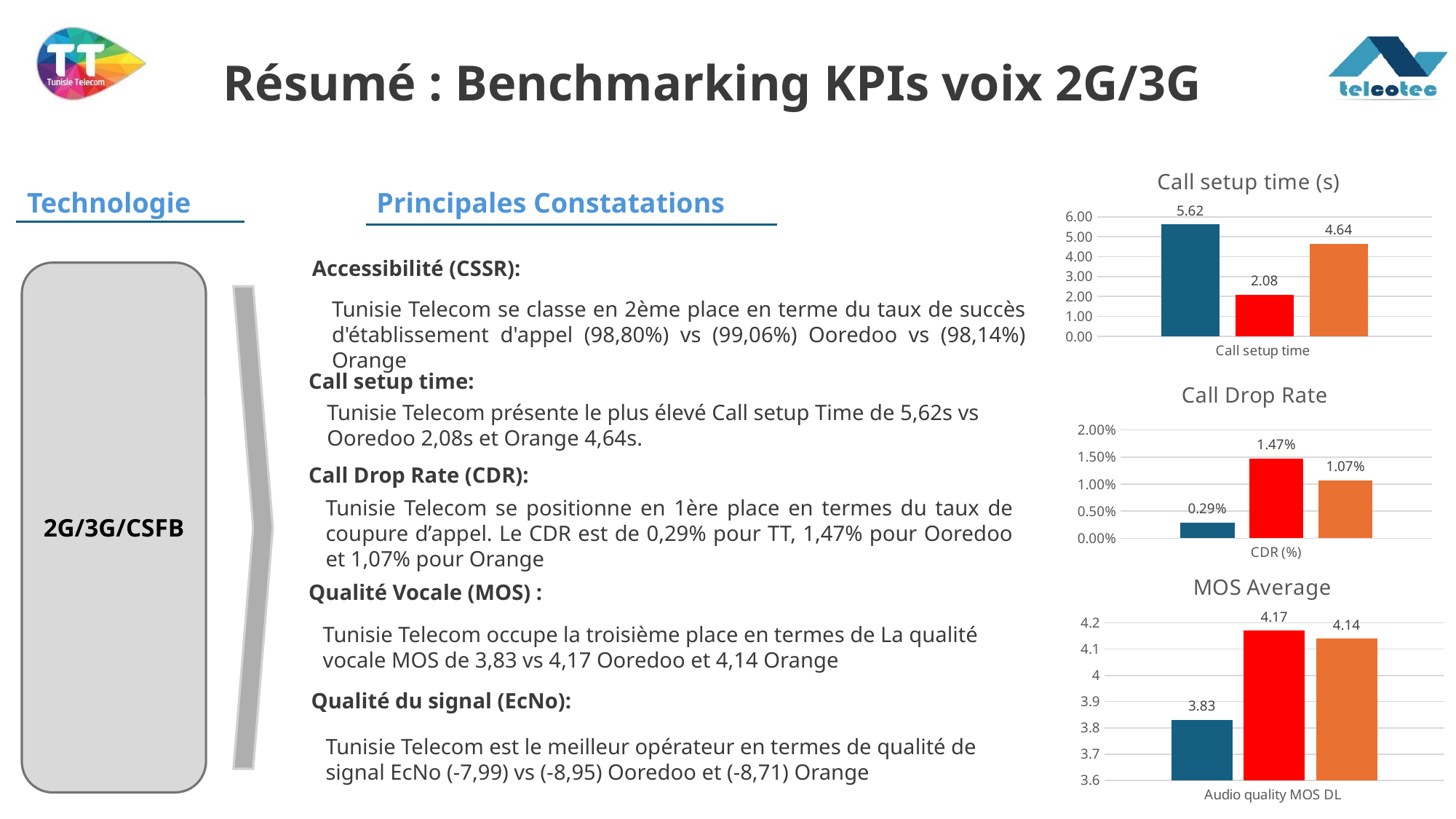
In the 'Call Drop Rate' chart, what is the value shown on the red bar? 1.47% In the 'Call setup time (s)' chart, which bar is the lowest? The red bar (2.08) In the 'Call Drop Rate' chart, what is the difference between the red bar and the orange bar? 0.40% In the 'Call setup time (s)' chart, what is the difference between the dark blue bar and the orange bar? 0.98 In the 'Call setup time (s)' chart, is the value of the dark blue bar greater or less than 5.00? greater What type of chart is the 'MOS Average' chart? Bar chart How many bars are plotted in the 'Call Drop Rate' chart? 3 In the 'Call setup time (s)' chart, what is the value shown on the dark blue bar? 5.62 In the 'Call Drop Rate' chart, which bar is the lowest? The dark blue bar (0.29%) In the 'MOS Average' chart, which is larger, the red bar or the orange bar? The red bar (4.17) In the 'MOS Average' chart, what is the difference between the red bar and the dark blue bar? 0.34 In the 'MOS Average' chart, what is the value shown on the orange bar? 4.14